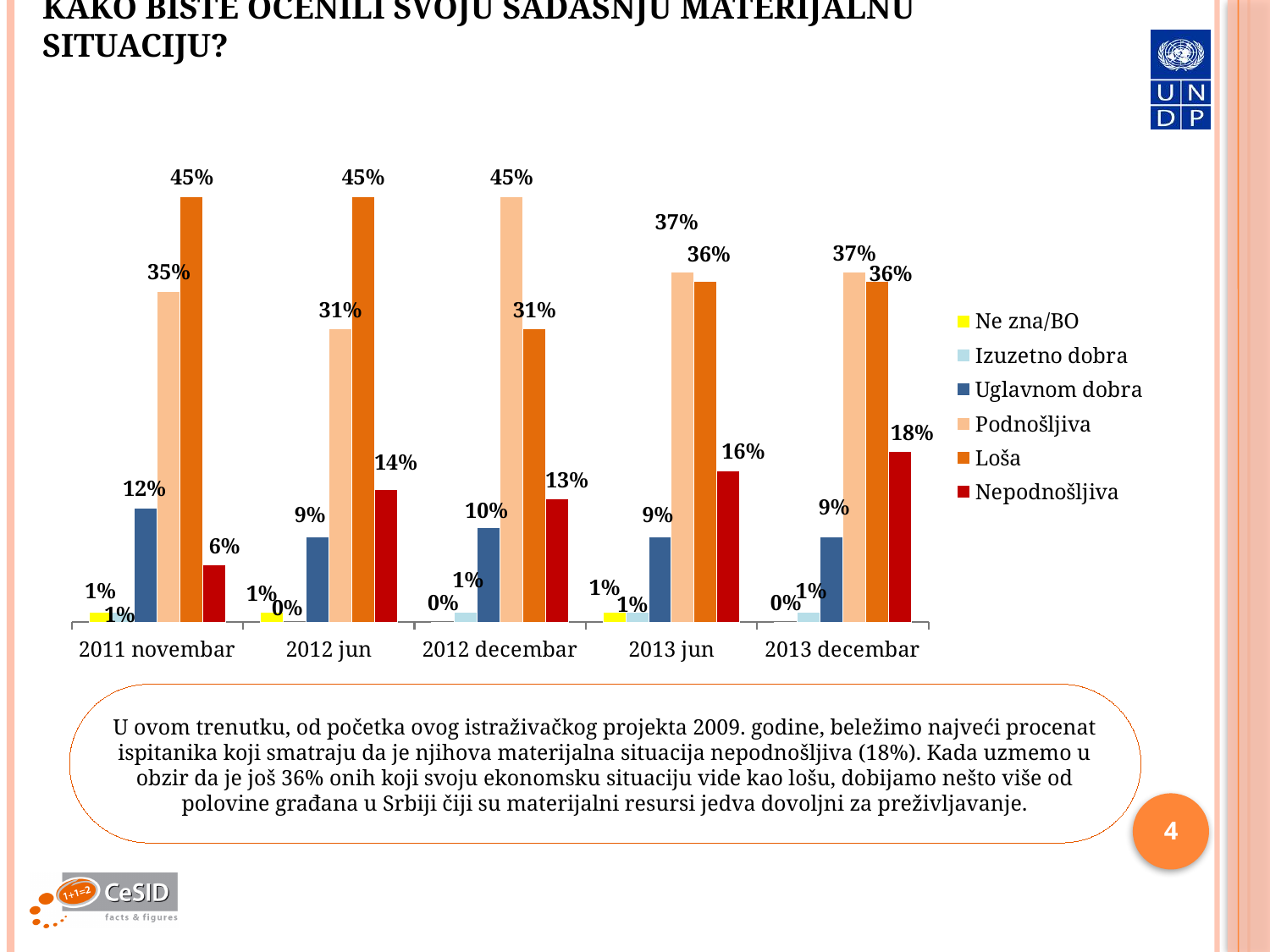
What is the value for Uglavnom dobra in 2011 novembar? 12% What is the value for Loša in 2011 novembar? 45% In which period is the Nepodnošljiva value lowest? 2011 novembar Which is larger in 2012 decembar: Podnošljiva or Loša? Podnošljiva Does the Nepodnošljiva value rise or fall from 2011 novembar to 2013 decembar? Rise How many series does the legend list? 6 What kind of chart is shown on the slide? Bar chart What is the value for Nepodnošljiva in 2013 decembar? 18% What is the value for Podnošljiva in 2012 decembar? 45% What is the difference between the Loša value in 2011 novembar and the Loša value in 2013 decembar? 9% In which period is the Nepodnošljiva value highest? 2013 decembar How many time periods are shown on the x axis? 5